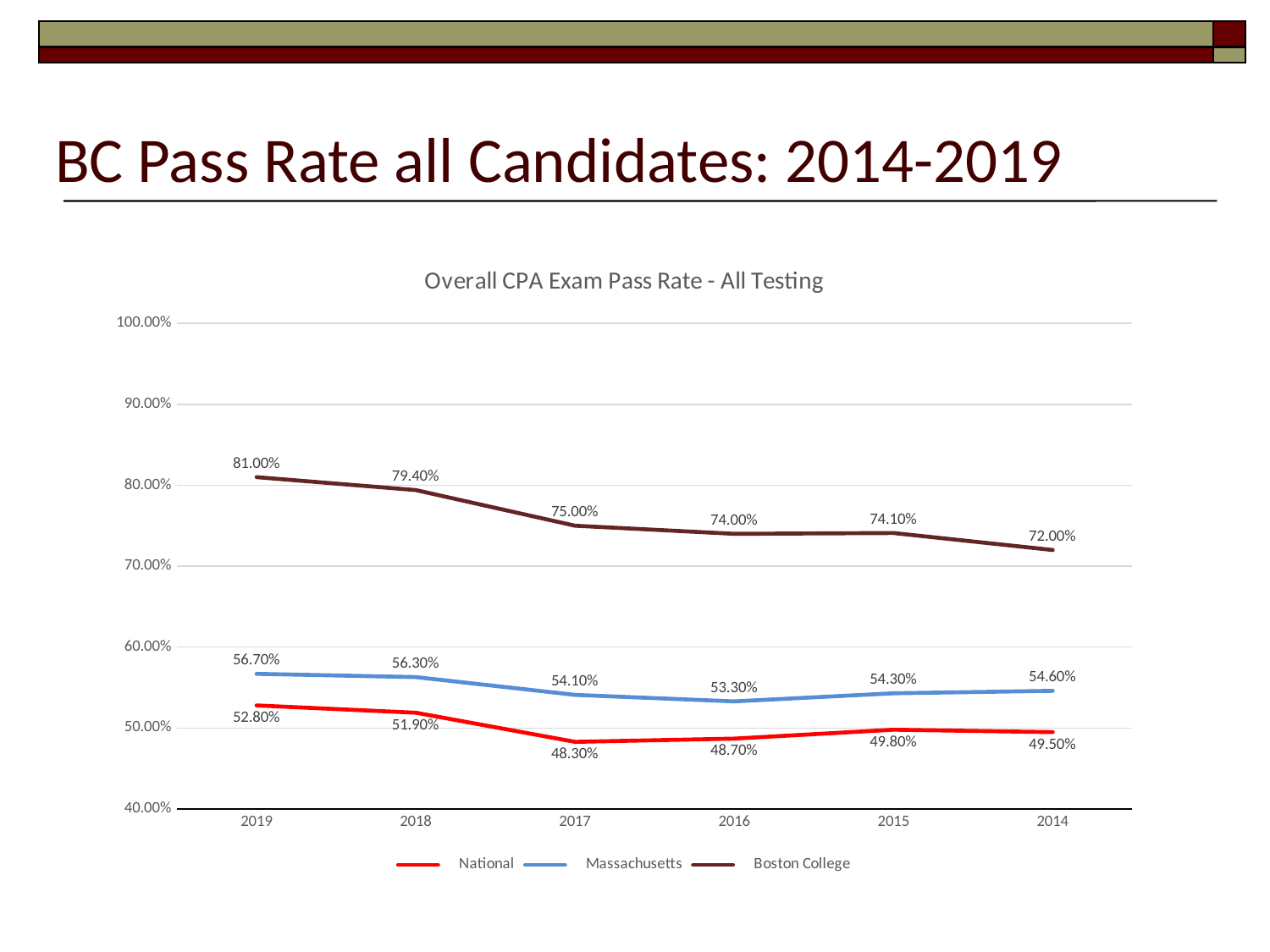
What is the difference between the Boston College and National pass rates in 2014? 22.50% Is the Boston College pass rate for 2018 greater or less than 70.00%? greater What kind of chart is shown on the slide? line chart What is the Massachusetts pass rate for 2016? 53.30% Does the Boston College line rise or fall moving from left (2019) to right (2014) along the x axis? fall How many series does the legend list? 3 How many years are shown on the x axis? 6 What is the National pass rate for 2017? 48.30% What is the Boston College pass rate for 2019? 81.00% Which is larger in 2015: the Massachusetts pass rate or the National pass rate? Massachusetts In which year is the Boston College pass rate highest? 2019 In which year is the National pass rate lowest? 2017